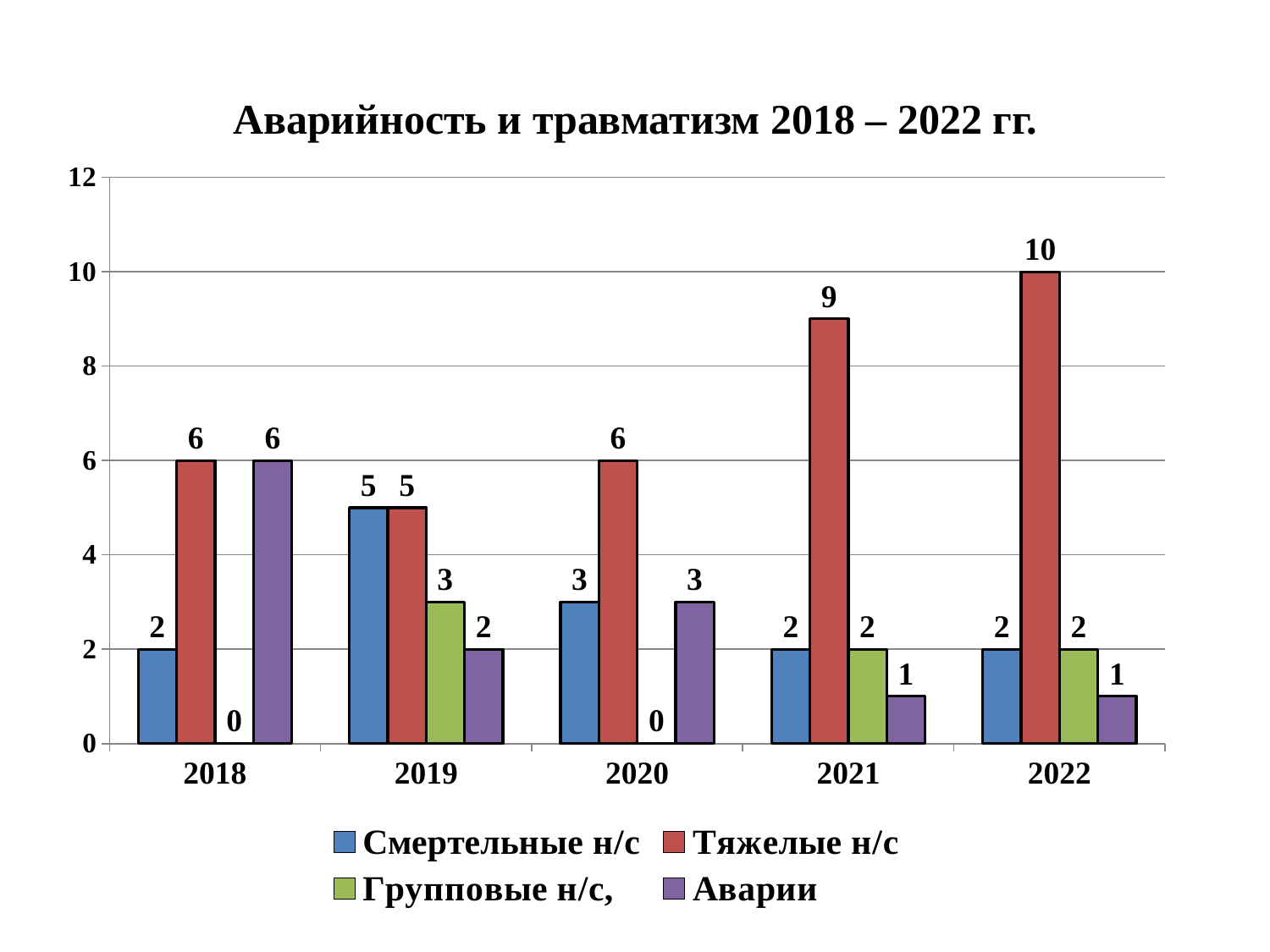
What is the difference between Тяжелые н/с in 2022 and in 2018? 4 In which year is the value for Тяжелые н/с the highest? 2022 What kind of chart is shown? Bar chart How many years are shown on the x axis? 5 What is the value for Смертельные н/с in 2019? 5 What is the value for Тяжелые н/с in 2022? 10 How many series does the legend list? 4 Does the value for Тяжелые н/с rise or fall from 2020 to 2022? Rise In which year is the value for Аварии the lowest? 2021 and 2022 Which is larger: Аварии in 2020 or Аварии in 2019? Аварии in 2020 What is the value for Аварии in 2018? 6 What is the value for Групповые н/с in 2020? 0